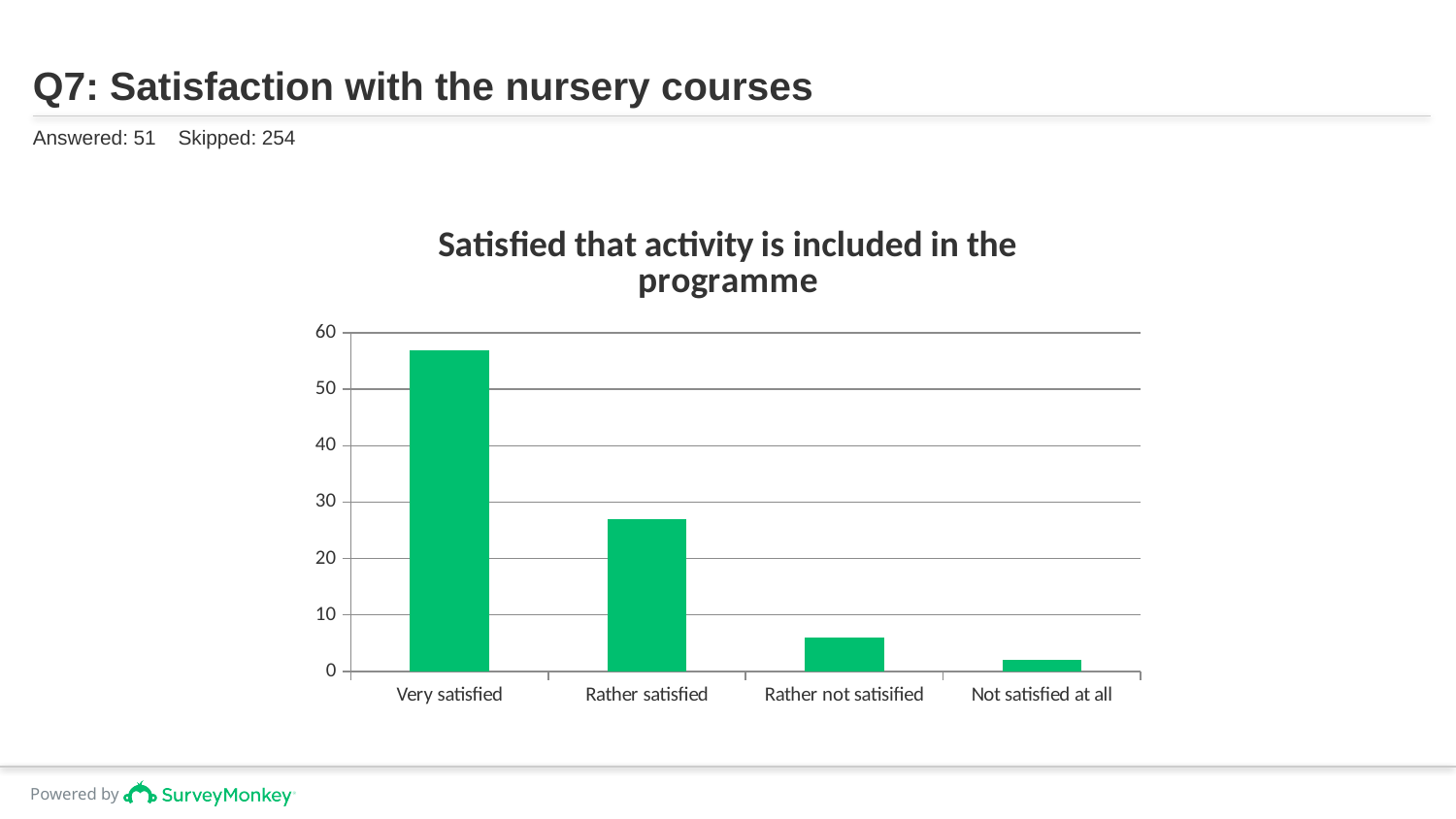
Which is larger, the value for Rather satisfied or the value for Rather not satisified? Rather satisfied Is the value for Very satisfied greater or less than 50? greater What colour are the bars in the chart? green Which category has the highest bar? Very satisfied Is the value for Rather satisfied greater or less than 20? greater Do the values rise or fall moving from left to right along the x axis? fall Is the value for Rather not satisified greater or less than 10? less Which category has the lowest bar? Not satisfied at all What kind of chart is shown on the slide? bar chart What is the title of the chart? Satisfied that activity is included in the programme How many categories are shown on the x axis? 4